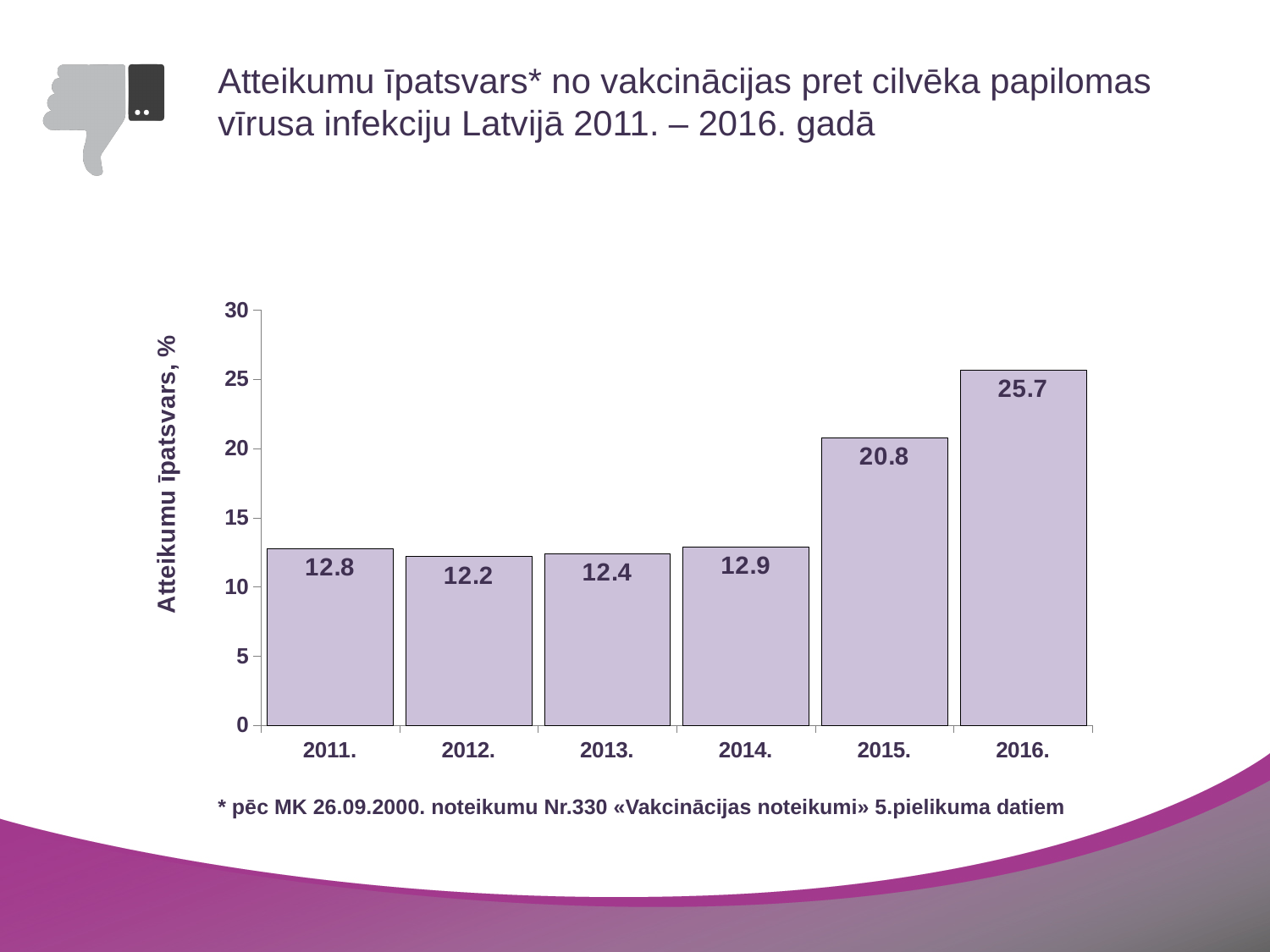
What is the difference between the values for 2014. and 2011.? 0.1 Which year has the lowest value? 2012. Which is larger, the value for 2015. or the value for 2014.? 2015. What is the value for 2015.? 20.8 What is the value for 2013.? 12.4 What kind of chart is shown on the slide? bar chart How many years are shown on the x axis? 6 What is the label of the y axis? Atteikumu īpatsvars, % What is the value for 2011.? 12.8 What is the difference between the values for 2016. and 2015.? 4.9 Is the value for 2016. greater or less than 25? greater Which year has the highest value? 2016.